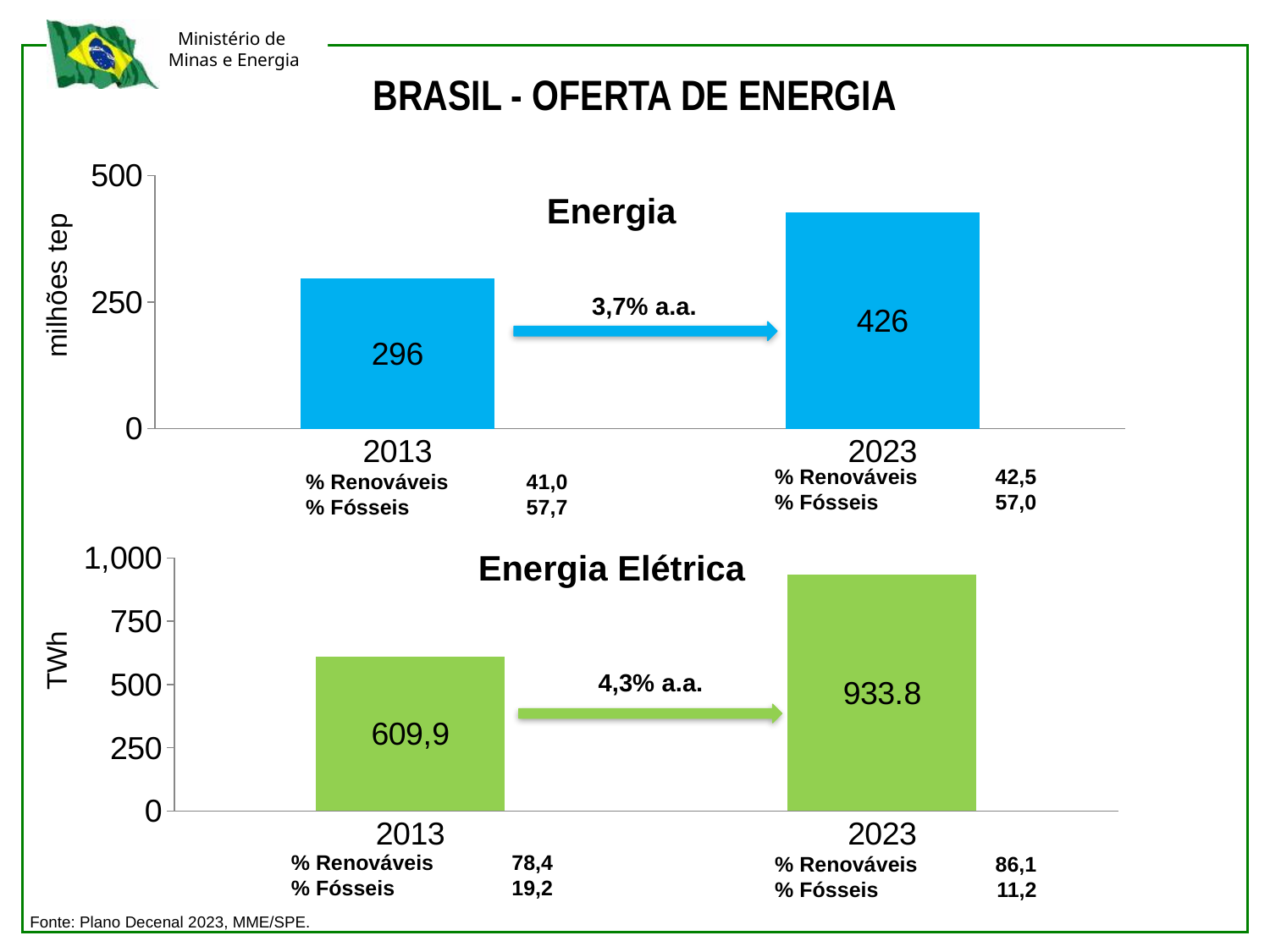
In the 'Energia' chart, what is the value for 2013? 296 In the 'Energia' chart, is the value for 2013 greater or less than 250? greater In the 'Energia Elétrica' chart, which year has the lower value? 2013 In the 'Energia' chart, what is the difference between the 2023 and 2013 values? 130 What type of chart is the 'Energia' chart? bar chart In the 'Energia Elétrica' chart, what is the value for 2013? 609,9 What unit is shown on the y axis of the 'Energia Elétrica' chart? TWh In the 'Energia' chart, which year has the higher value? 2023 How many bars are plotted in the 'Energia Elétrica' chart? 2 In the 'Energia Elétrica' chart, is the value for 2023 greater or less than 750? greater In the 'Energia' chart, what is the value for 2023? 426 In the 'Energia Elétrica' chart, what is the value for 2023? 933.8